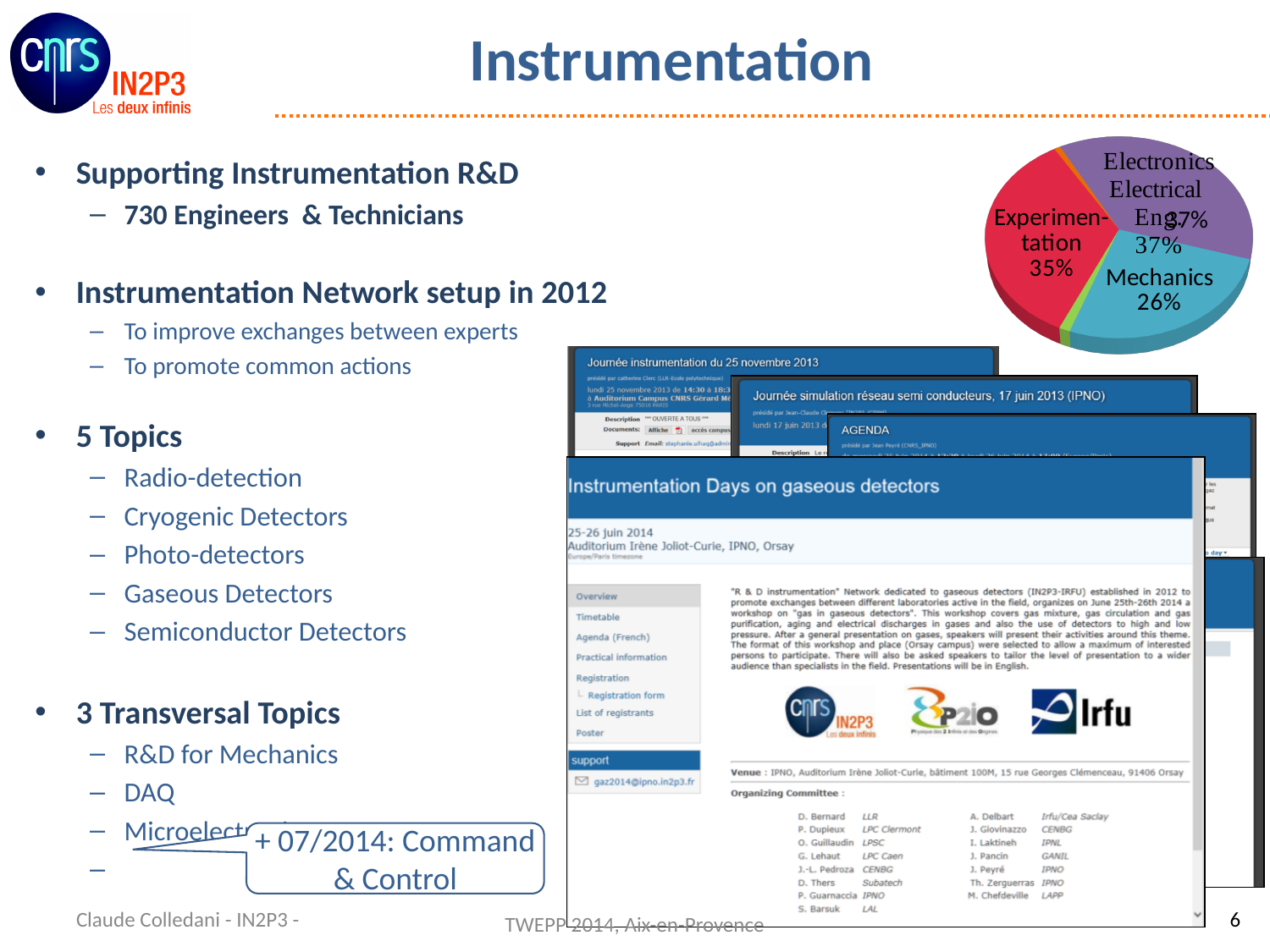
What is the difference in percentage points between Electronics Electrical Eng and Mechanics? 11 What share does Experimentation have in the pie chart? 35% What is the difference in percentage points between Experimentation and Mechanics? 9 Which labeled category has the largest share of the pie chart? Electronics Electrical Eng What percentage is shown for Electronics Electrical Eng in the pie chart? 37% What kind of chart is shown on the slide? Pie chart What percentage of the pie chart is Mechanics? 26% Which of the labeled categories has the smallest share of the pie chart? Mechanics What colour is the Mechanics slice of the pie chart? Teal Which has a larger share, Experimentation or Mechanics? Experimentation What colour is the Experimentation slice of the pie chart? Red How many labeled categories does the pie chart show? 3